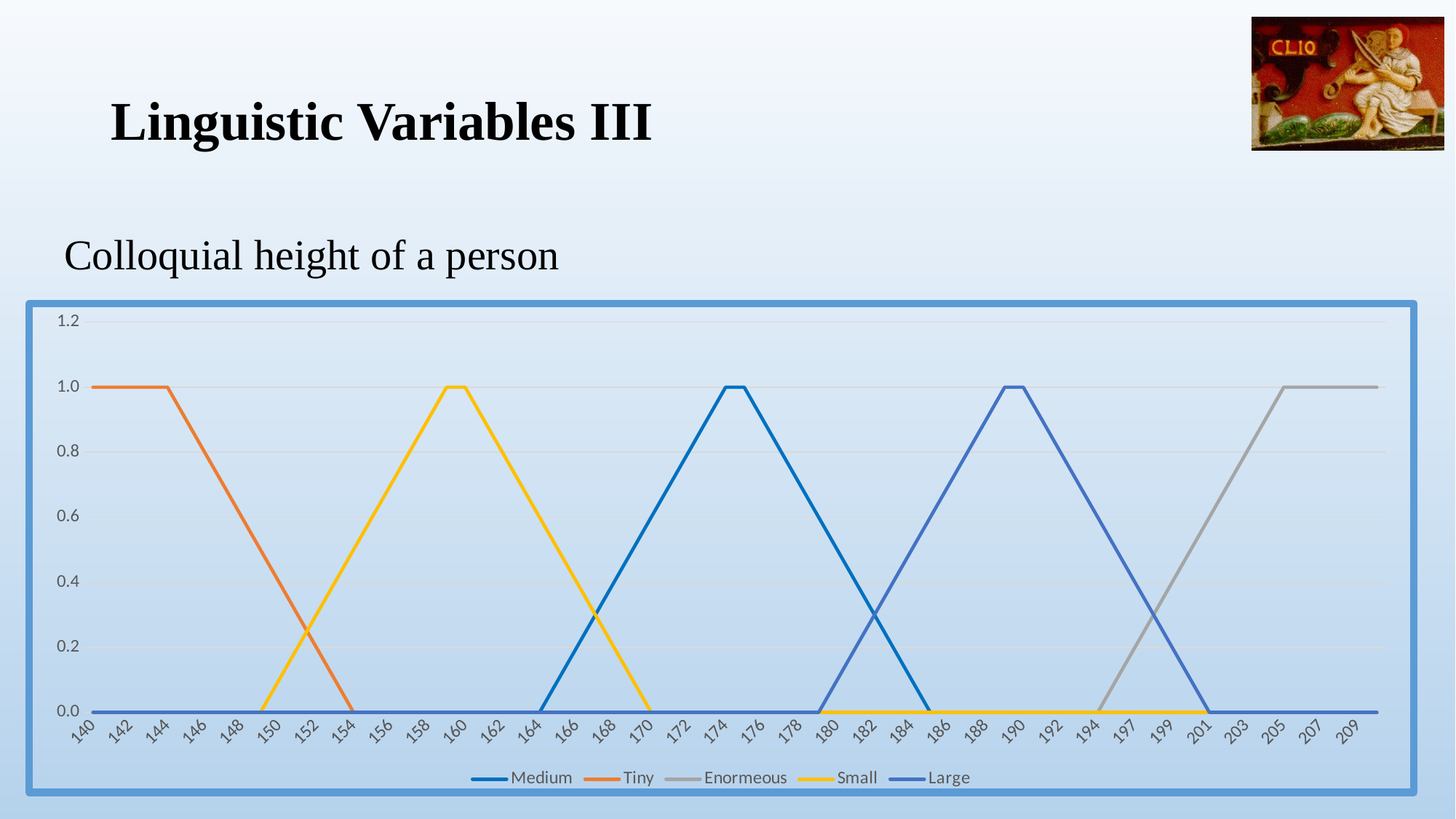
Is the value of the Medium series at 170 greater or less than 0.4? greater What is the value of the Enormeous series at 209? 1.0 How many series does the legend list? 5 Is the value of the Enormeous series at 203 greater or less than 0.6? greater Which series has the highest value at 209? Enormeous What colour is the Tiny series line? orange What is the value of the Tiny series at 140? 1.0 What is the value of the Medium series at 140? 0.0 At 180, which series has the larger value, Medium or Large? Medium Which series has the highest value at 140? Tiny Does the Tiny series rise or fall between 144 and 154? fall What kind of chart is shown on the slide? line chart